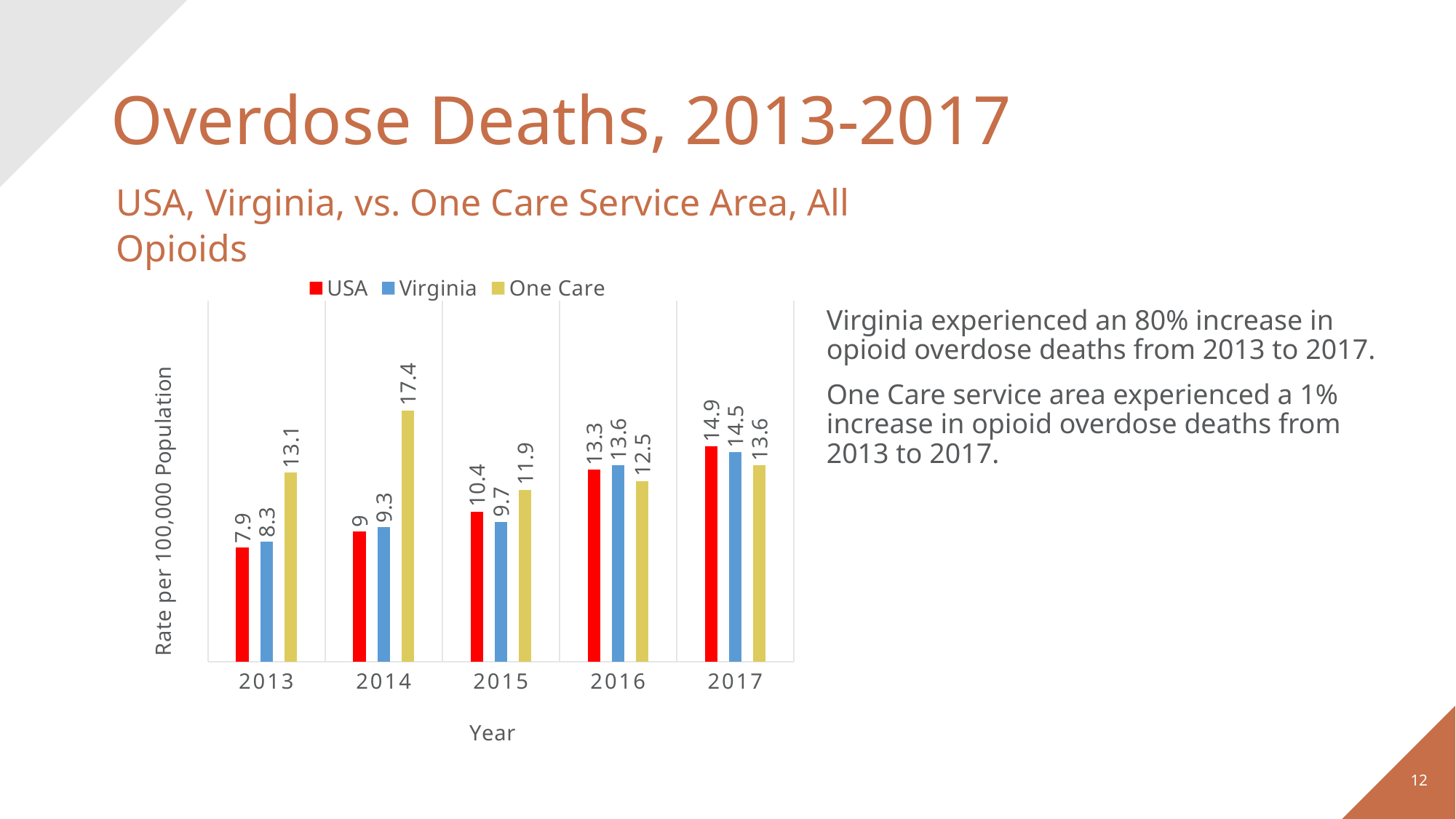
What is the USA rate per 100,000 population in 2013? 7.9 What is the One Care rate per 100,000 population in 2014? 17.4 How many series does the legend list? 3 Does the USA rate rise or fall from 2013 to 2017? Rise How many years are shown on the x axis? 5 What kind of chart is shown on the slide? Bar chart What is the difference between the One Care rate and the USA rate in 2014? 8.4 What is the label of the y axis? Rate per 100,000 Population In which year is the USA rate lowest? 2013 Which is larger in 2017, the USA rate or the One Care rate? USA What is the Virginia rate per 100,000 population in 2017? 14.5 In which year is the One Care rate highest? 2014